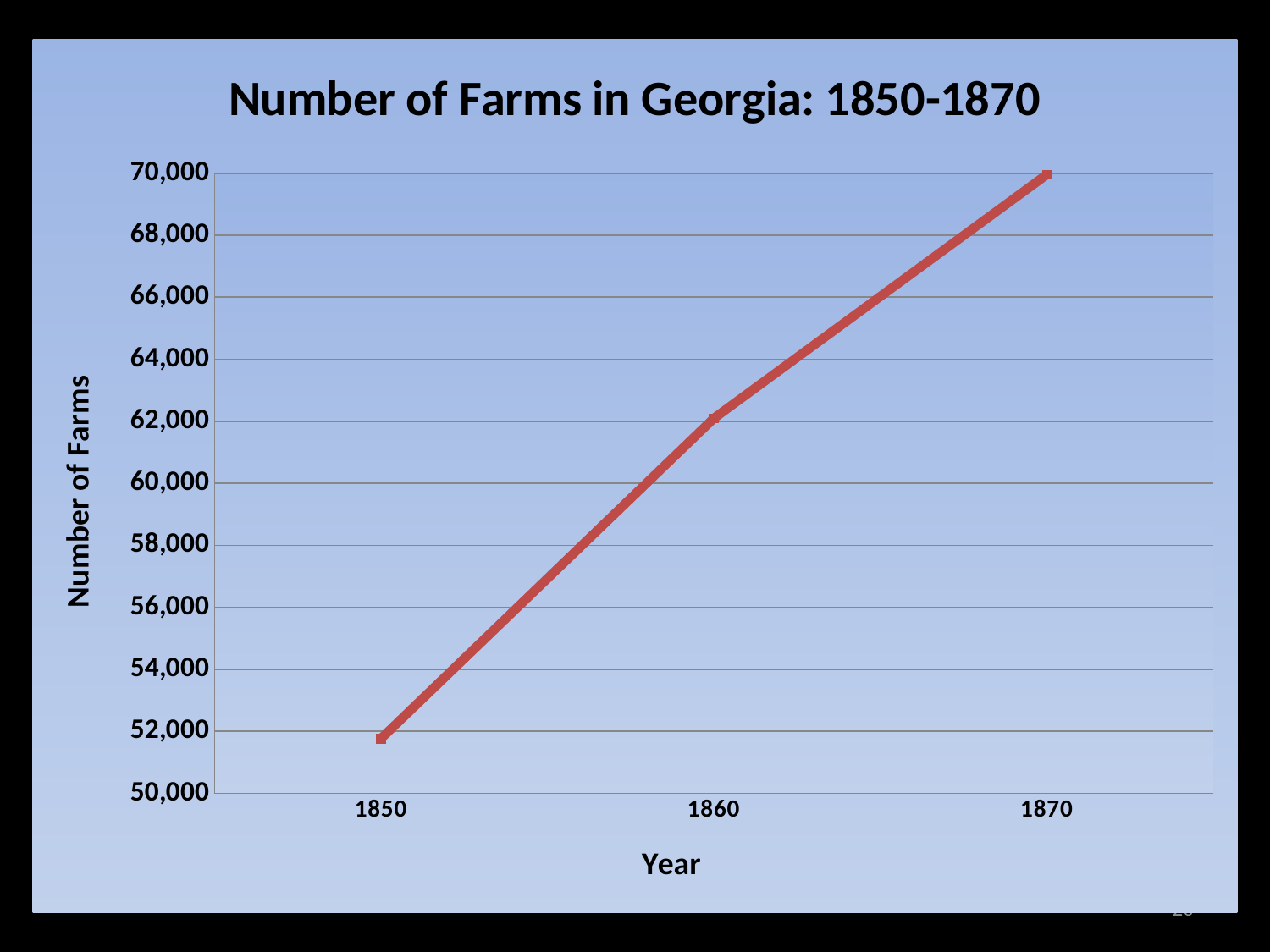
Is the value for 1860 greater or less than 64,000? less Which year has the lowest number of farms? 1850 Is the value for 1850 greater or less than 52,000? less What is the title of the chart? Number of Farms in Georgia: 1850-1870 Is the value for 1870 greater or less than 68,000? greater Do the values rise or fall from 1850 to 1870? rise What is the label of the y axis? Number of Farms Which year has the highest number of farms? 1870 How many years are plotted on the x axis? 3 What kind of chart is shown on the slide? line chart Which is larger, the value for 1850 or the value for 1860? 1860